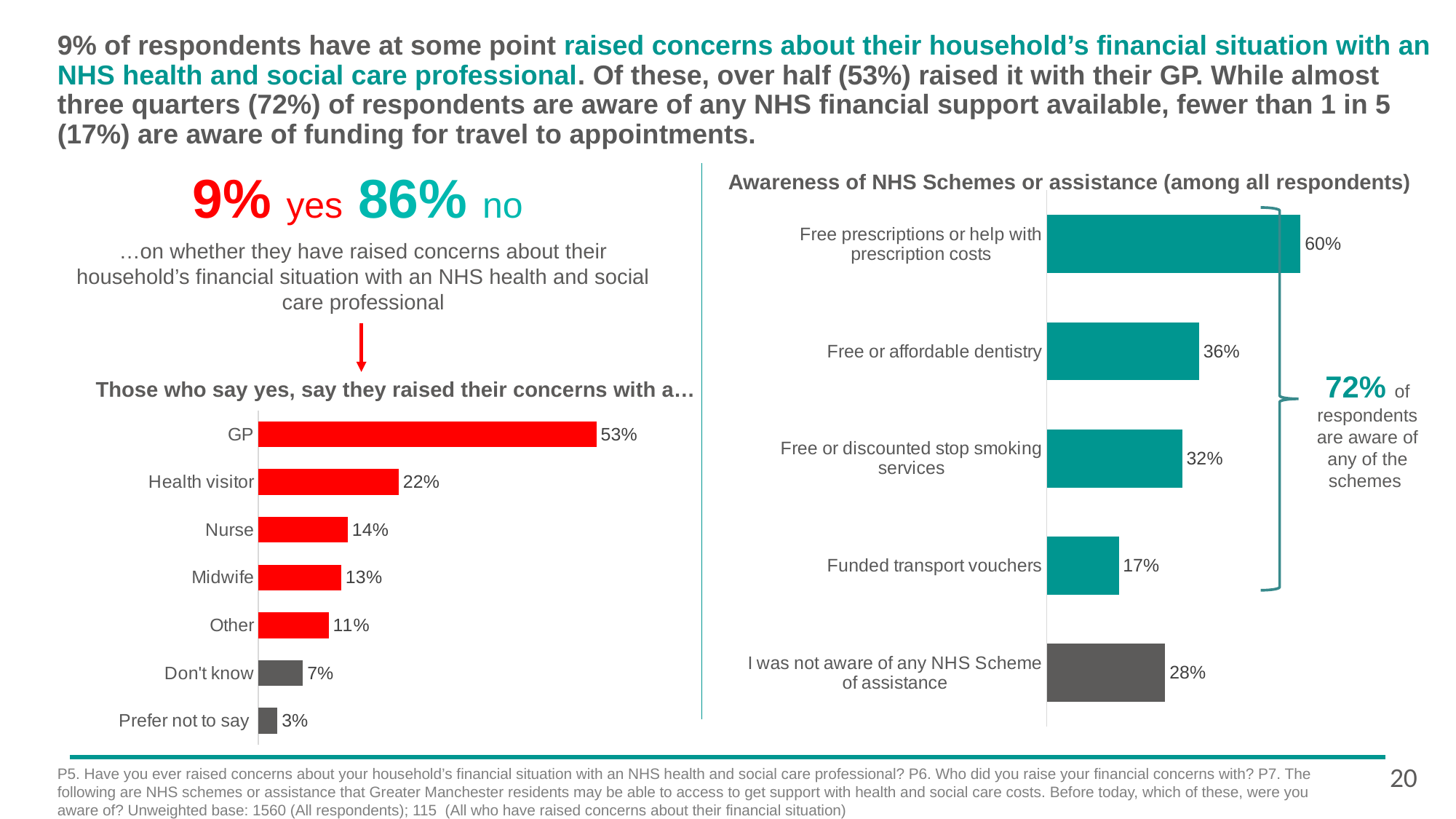
In the chart 'Those who say yes, say they raised their concerns with a…', what is the difference between the values for Nurse and Midwife? 1% In the chart 'Those who say yes, say they raised their concerns with a…', what percentage raised their concerns with a GP? 53% In the chart 'Awareness of NHS Schemes or assistance (among all respondents)', what is the value for Funded transport vouchers? 17% In the chart 'Awareness of NHS Schemes or assistance (among all respondents)', what is the value for Free or affordable dentistry? 36% What type of chart is 'Awareness of NHS Schemes or assistance (among all respondents)'? Bar chart In the chart 'Those who say yes, say they raised their concerns with a…', which category has the lowest value? Prefer not to say In the chart 'Those who say yes, say they raised their concerns with a…', what is the value for Health visitor? 22% In the chart 'Awareness of NHS Schemes or assistance (among all respondents)', what is the difference between Free prescriptions or help with prescription costs and Free or affordable dentistry? 24% In the chart 'Awareness of NHS Schemes or assistance (among all respondents)', which scheme has the highest awareness? Free prescriptions or help with prescription costs In the chart 'Those who say yes, say they raised their concerns with a…', what colour are the bars for Don't know and Prefer not to say? Grey In the chart 'Awareness of NHS Schemes or assistance (among all respondents)', which is larger: Free or discounted stop smoking services or I was not aware of any NHS Scheme of assistance? Free or discounted stop smoking services In the chart 'Those who say yes, say they raised their concerns with a…', how many categories are shown? 7